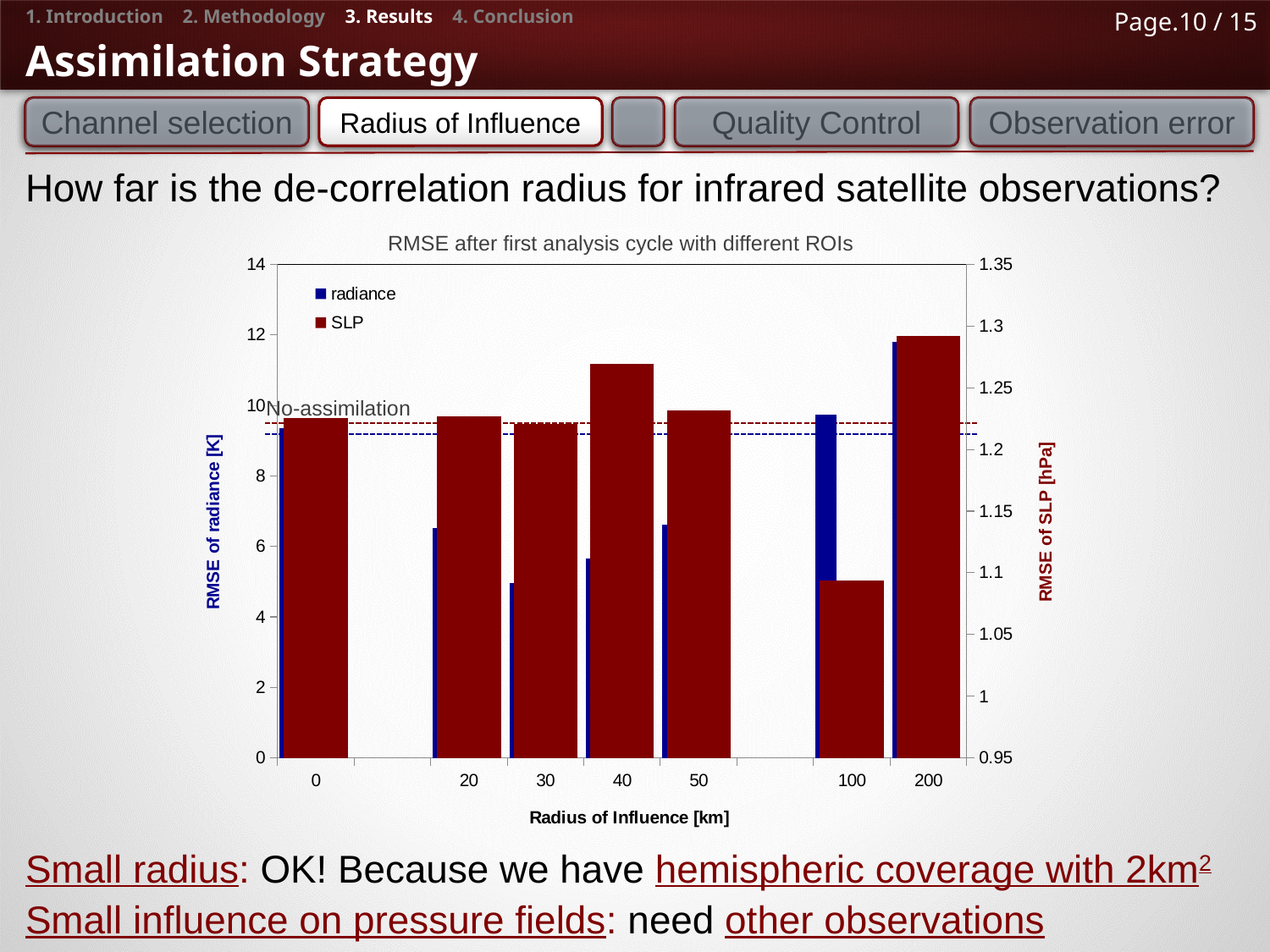
What kind of chart is shown on the slide? bar chart Which radius of influence has the highest RMSE of radiance? 200 Is the RMSE of radiance for a radius of influence of 30 km greater or less than 6? less How many radius of influence categories are shown on the x axis? 7 Which radius of influence has the highest RMSE of SLP? 200 Which radius of influence has the lowest RMSE of SLP? 100 What is the title of the chart? RMSE after first analysis cycle with different ROIs What is the label of the right-hand vertical axis? RMSE of SLP [hPa] Is the RMSE of SLP for a radius of influence of 100 km greater or less than 1.1? less Which has a larger RMSE of radiance: a radius of influence of 20 km or 100 km? 100 km Which radius of influence has the lowest RMSE of radiance? 30 How many series does the legend list? 2